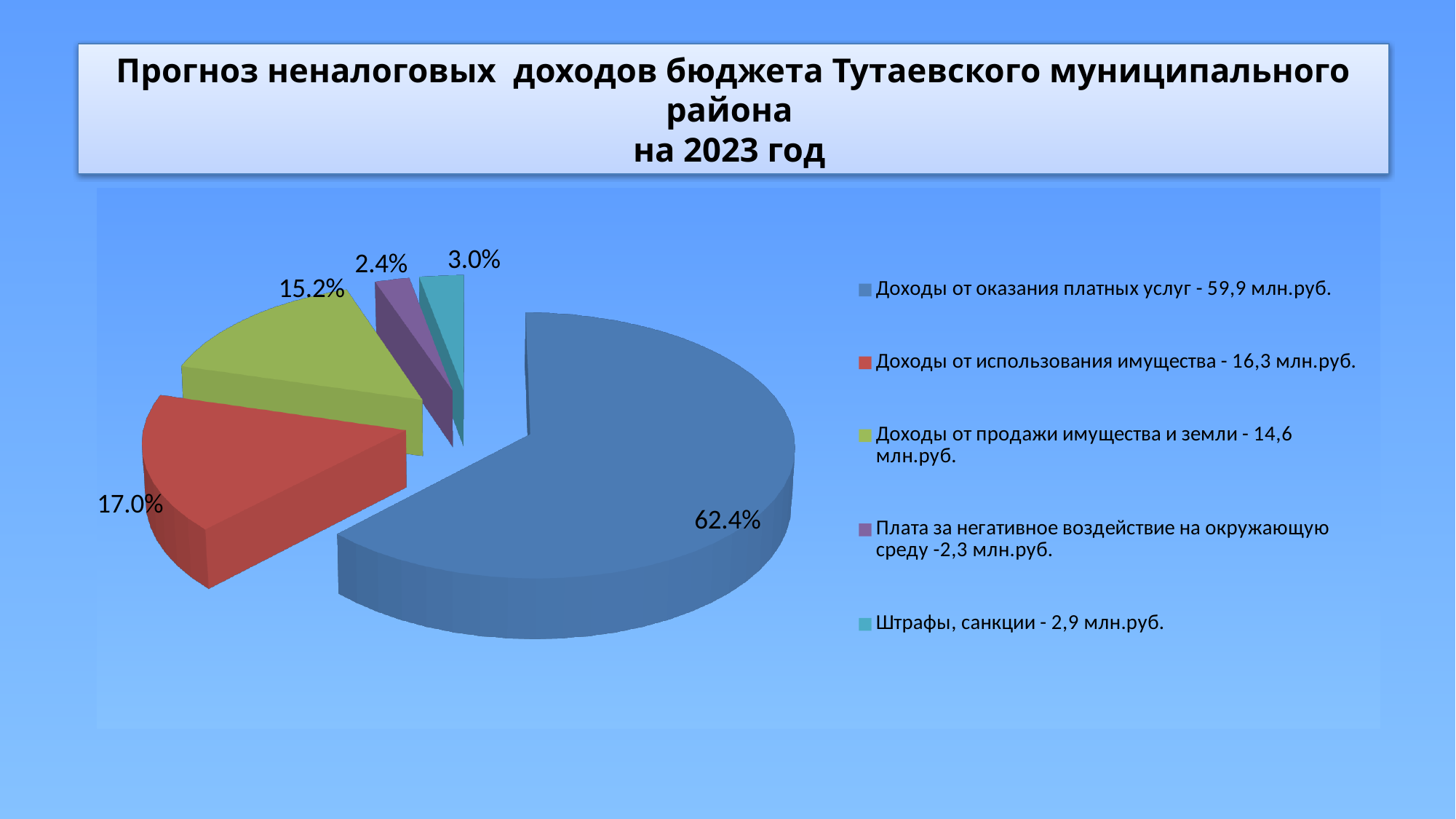
Which category has the largest share of the pie? Доходы от оказания платных услуг What share of the pie does "Доходы от оказания платных услуг" have? 62.4% What share of the pie does "Доходы от использования имущества" have? 17.0% What type of chart is shown on the slide? Pie chart How many slices does the pie chart have? 5 According to the legend, what amount in млн.руб. is given for "Доходы от оказания платных услуг"? 59,9 млн.руб. What share of the pie does "Доходы от продажи имущества и земли" have? 15.2% Which has a larger share: "Штрафы, санкции" or "Плата за негативное воздействие на окружающую среду"? Штрафы, санкции What colour is the slice for "Доходы от продажи имущества и земли"? Green What is the difference in percentage points between the shares of "Доходы от использования имущества" and "Доходы от продажи имущества и земли"? 1.8 Which category has the smallest share of the pie? Плата за негативное воздействие на окружающую среду